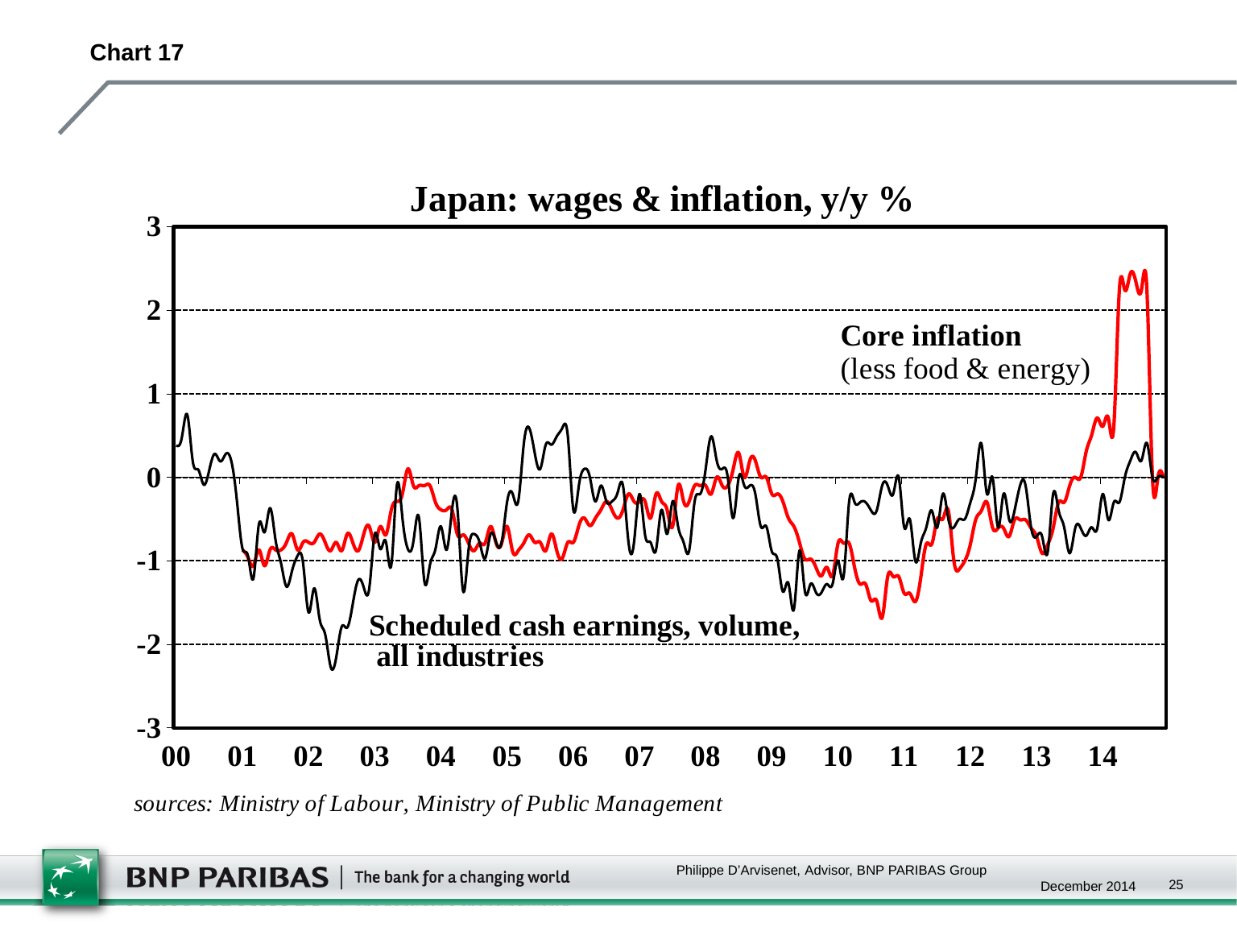
At its 2014 peak, which series is higher: core inflation or scheduled cash earnings? Core inflation How many year labels are shown on the x axis? 15 What kind of chart is shown on the slide? Line chart Is the peak value of core inflation in 2014 greater or less than 2? greater Does core inflation rise or fall from 2013 to mid-2014? Rise Which series reaches the lowest value on the chart? Scheduled cash earnings, volume, all industries Which series is drawn in red? Core inflation (less food & energy) Is the value of core inflation in late 2010 greater or less than -1? less How many series are plotted on the chart? 2 Is the lowest value of scheduled cash earnings in 2002 greater or less than -2? less What is the title of the chart? Japan: wages & inflation, y/y % Which series reaches the highest value on the chart? Core inflation